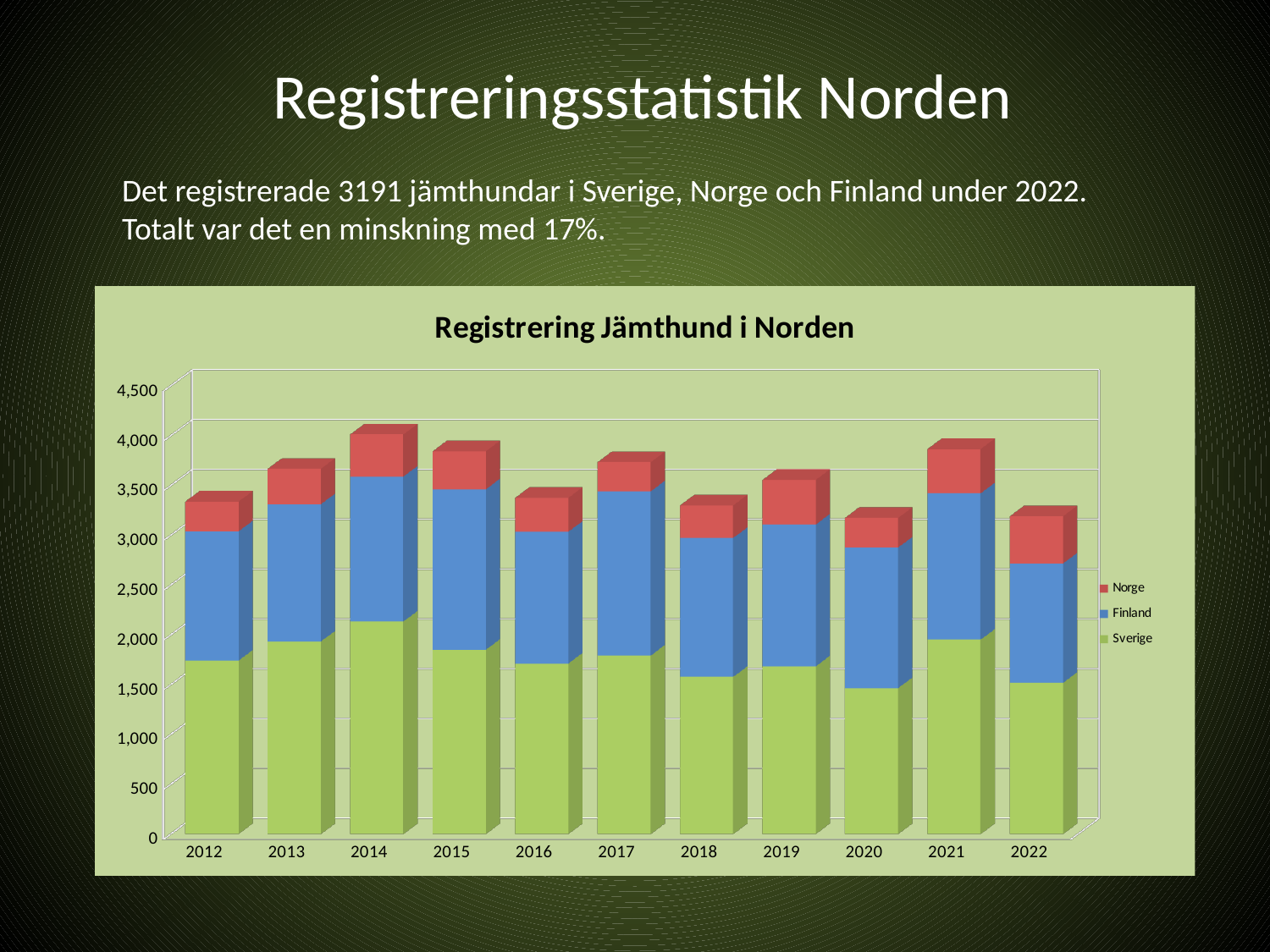
Which series are listed in the chart legend? Norge, Finland, Sverige Is the Sverige value for 2014 greater or less than 1,500? greater How many years are shown on the x axis of the chart? 11 How many series does the chart legend list? 3 Which year has the larger total bar, 2014 or 2016? 2014 Which year has the highest Sverige value in the chart? 2014 What kind of chart is shown on the slide? Stacked bar chart Which year has the highest total bar in the chart? 2014 Is the total bar for 2014 greater or less than 3,500? greater Is the total bar for 2012 greater or less than 3,500? less Does the total bar rise or fall from 2020 to 2021? rise What is the title of the chart? Registrering Jämthund i Norden